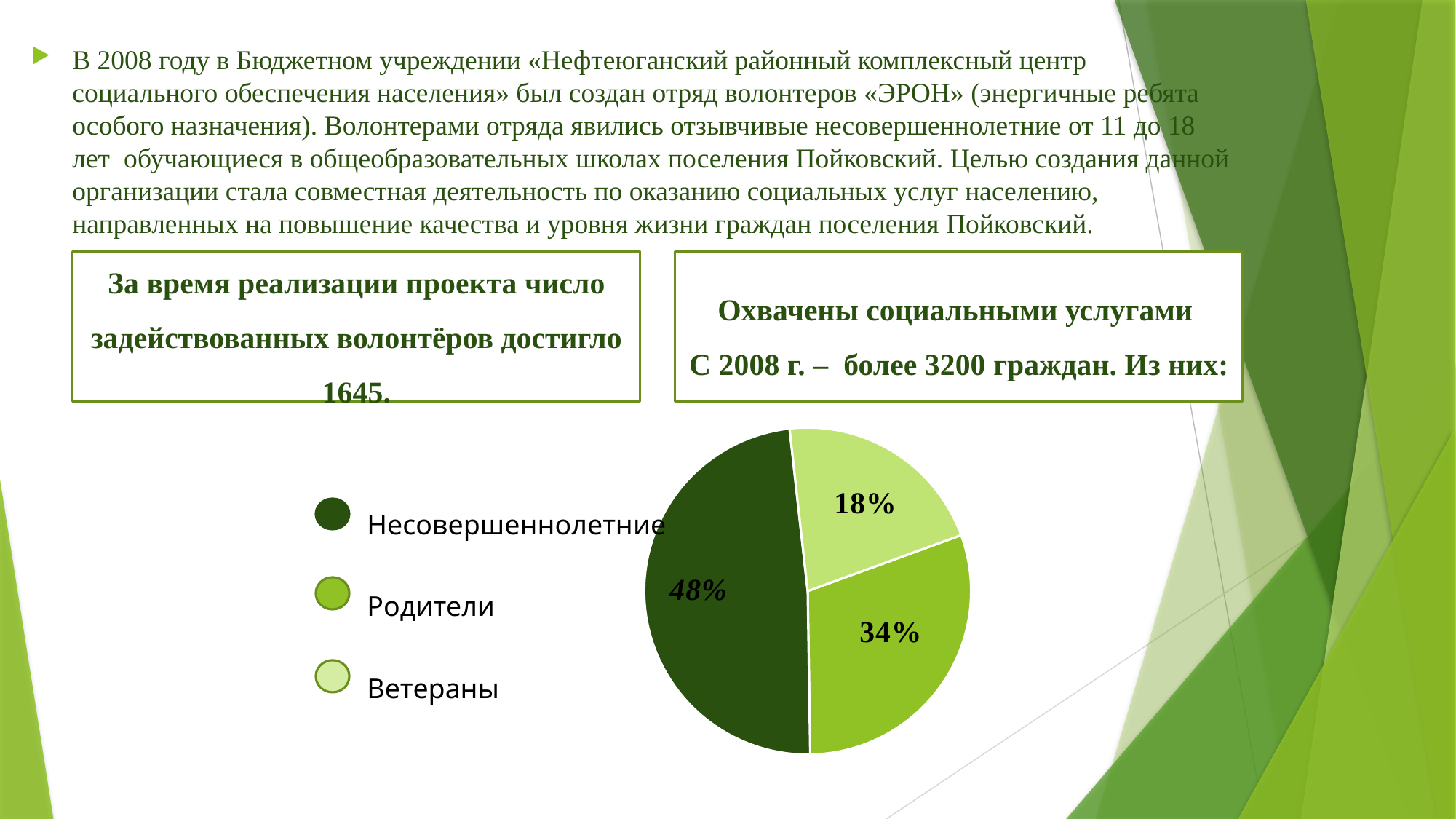
Which is larger, the share for Родители or the share for Ветераны? Родители What is the difference in percentage points between Несовершеннолетние and Родители? 14 What kind of chart is shown on the slide? pie chart How many categories does the pie chart show? 3 Which category is shown in the lightest green in the pie chart? Ветераны Which category has the largest slice of the pie chart? Несовершеннолетние Which category is shown in the darkest green in the pie chart? Несовершеннолетние What share of the pie chart is Родители? 34% What is the difference in percentage points between Родители and Ветераны? 16 What share of the pie chart is Несовершеннолетние? 48% Which category has the smallest slice of the pie chart? Ветераны What share of the pie chart is Ветераны? 18%